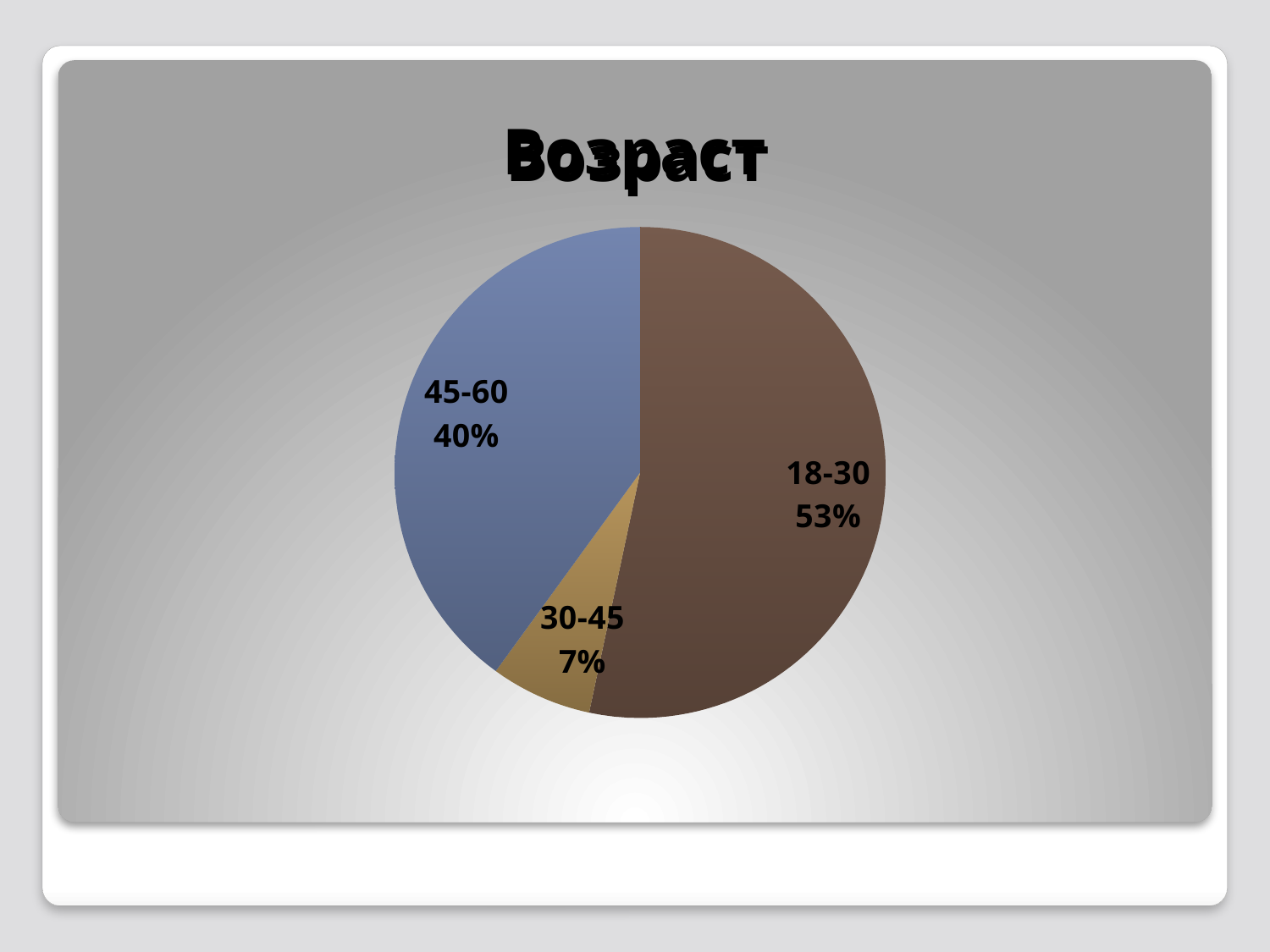
What is the title of the chart? Возраст Which slice is larger, 45-60 or 30-45? 45-60 What is the difference in percentage points between the 18-30 slice and the 45-60 slice? 13 What share of the pie does the 45-60 slice have? 40% What share of the pie does the 30-45 slice have? 7% What is the difference in percentage points between the 45-60 slice and the 30-45 slice? 33 What colour is the 18-30 slice? brown Which age group has the smallest slice? 30-45 Which age group has the largest slice? 18-30 What share of the pie does the 18-30 slice have? 53% What kind of chart is shown on the slide? pie chart How many slices does the pie chart have? 3